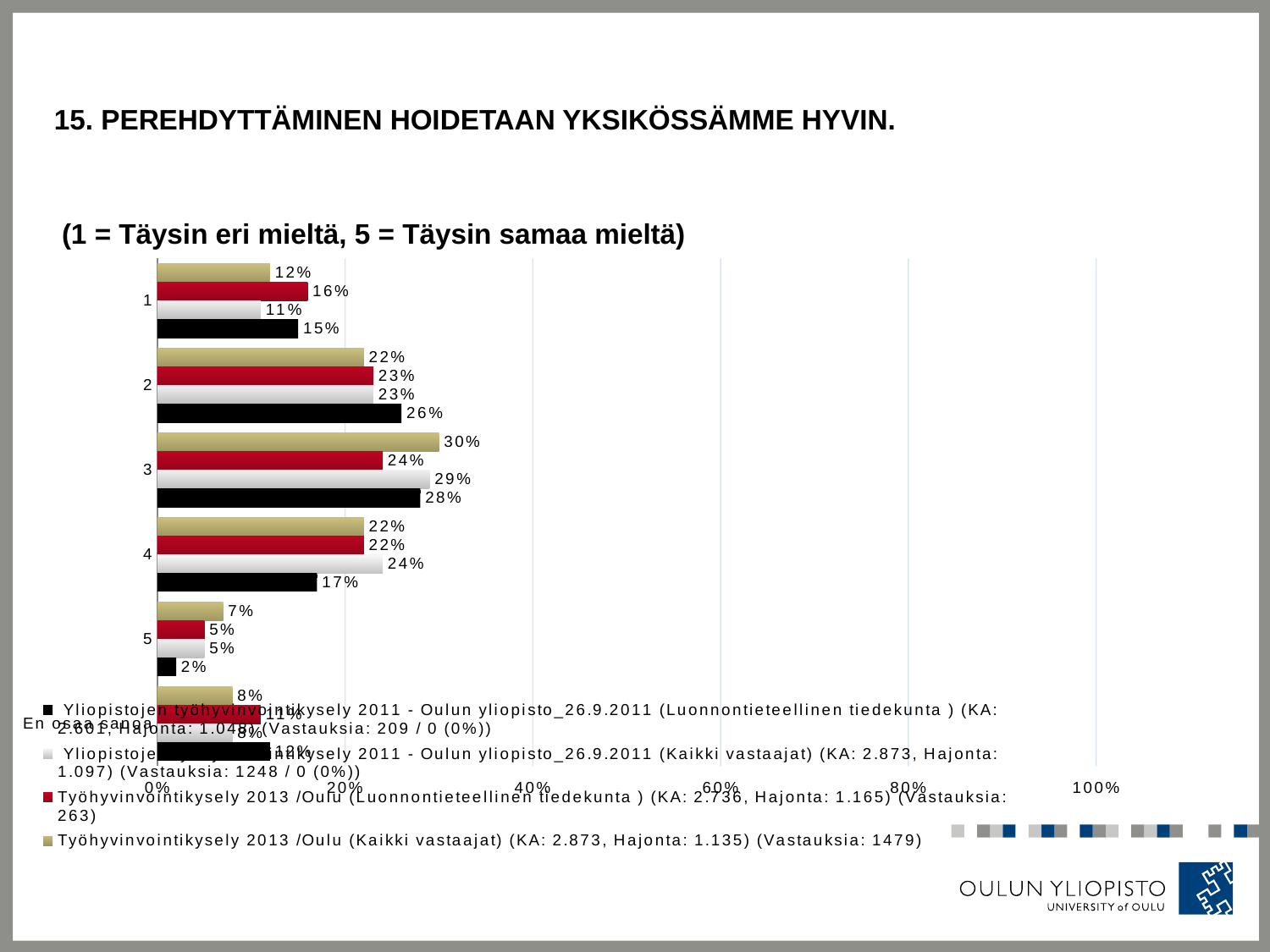
Is the value of the gold bar for category 3 greater or less than 20%? greater What type of chart is shown on the slide? bar chart For category 4, which is larger: the light gray bar (2011 Kaikki vastaajat) or the black bar (2011 Luonnontieteellinen tiedekunta)? the light gray bar (2011 Kaikki vastaajat) What is the value of the red bar (Työhyvinvointikysely 2013 /Oulu, Luonnontieteellinen tiedekunta) for category 1? 16% What is the difference between the black bar (26%) and the gold bar (22%) for category 2? 4% What is the value of the black bar (2011 Luonnontieteellinen tiedekunta) for category 5? 2% For the gold series (2013 /Oulu, Kaikki vastaajat), which of categories 1 to 5 has the highest value? 3 What is the difference between the red bar (24%) and the gold bar (30%) for category 3? 6% How many series does the legend list? 4 What is the value of the gold bar (Työhyvinvointikysely 2013 /Oulu, Kaikki vastaajat) for category 3? 30% What is the value of the light gray bar (2011 Kaikki vastaajat) for category 4? 24% For the black series (2011 Luonnontieteellinen tiedekunta), which of categories 1 to 5 has the lowest value? 5